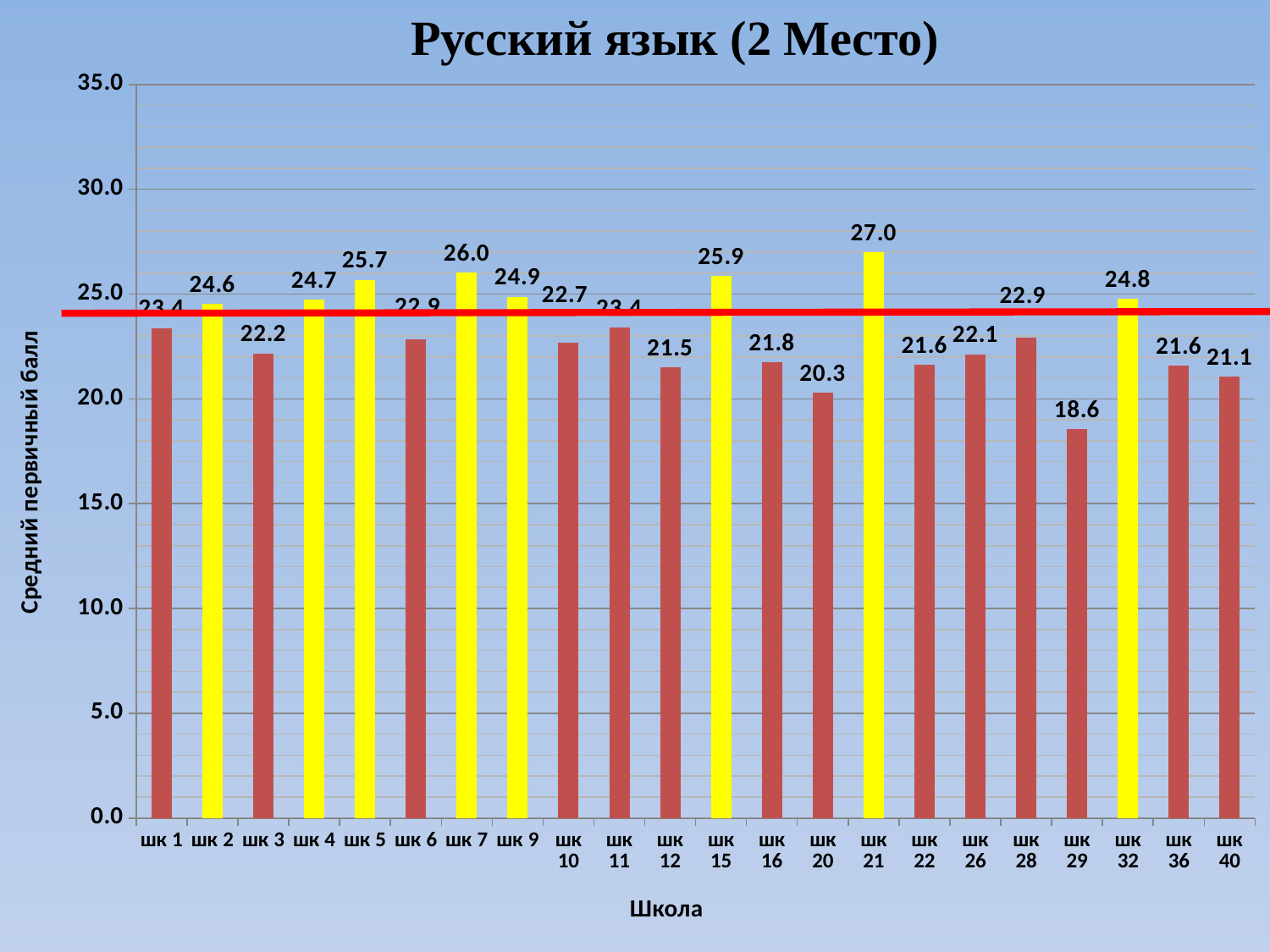
What is the value for шк 7? 26.0 What is the difference between the values for шк 21 and шк 29? 8.4 Is the value for шк 32 greater or less than 20.0? greater Which is larger, the value for шк 5 or the value for шк 15? шк 15 Which school has the lowest average score? шк 29 What is the value for шк 21? 27.0 Which school has the highest average score? шк 21 What is the value for шк 29? 18.6 What is the title of the chart? Русский язык (2 Место) What kind of chart is this? bar chart What is the value for шк 20? 20.3 How many schools are shown on the x axis? 22